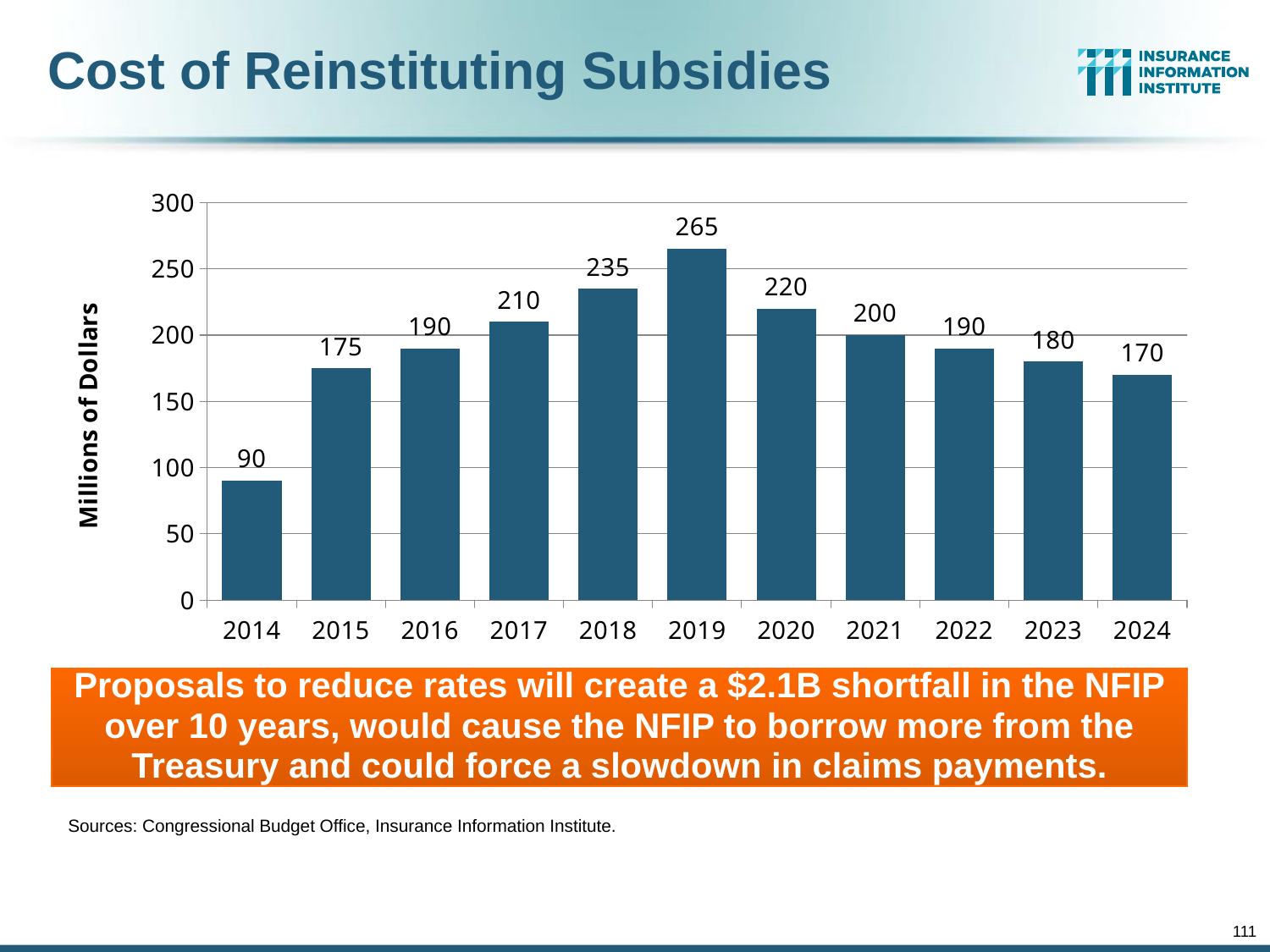
What is the value for 2024? 170 What is the label on the vertical axis? Millions of Dollars What is the value for 2019? 265 How many years are shown on the x axis? 11 Is the value for 2021 greater or less than 150? greater Which year has the highest value? 2019 What is the value for 2014? 90 Do the values rise or fall from 2019 to 2024? Fall What kind of chart is this? Bar chart What is the difference between the values for 2019 and 2014? 175 Which is larger, the value for 2018 or the value for 2020? 2018 Which year has the lowest value? 2014